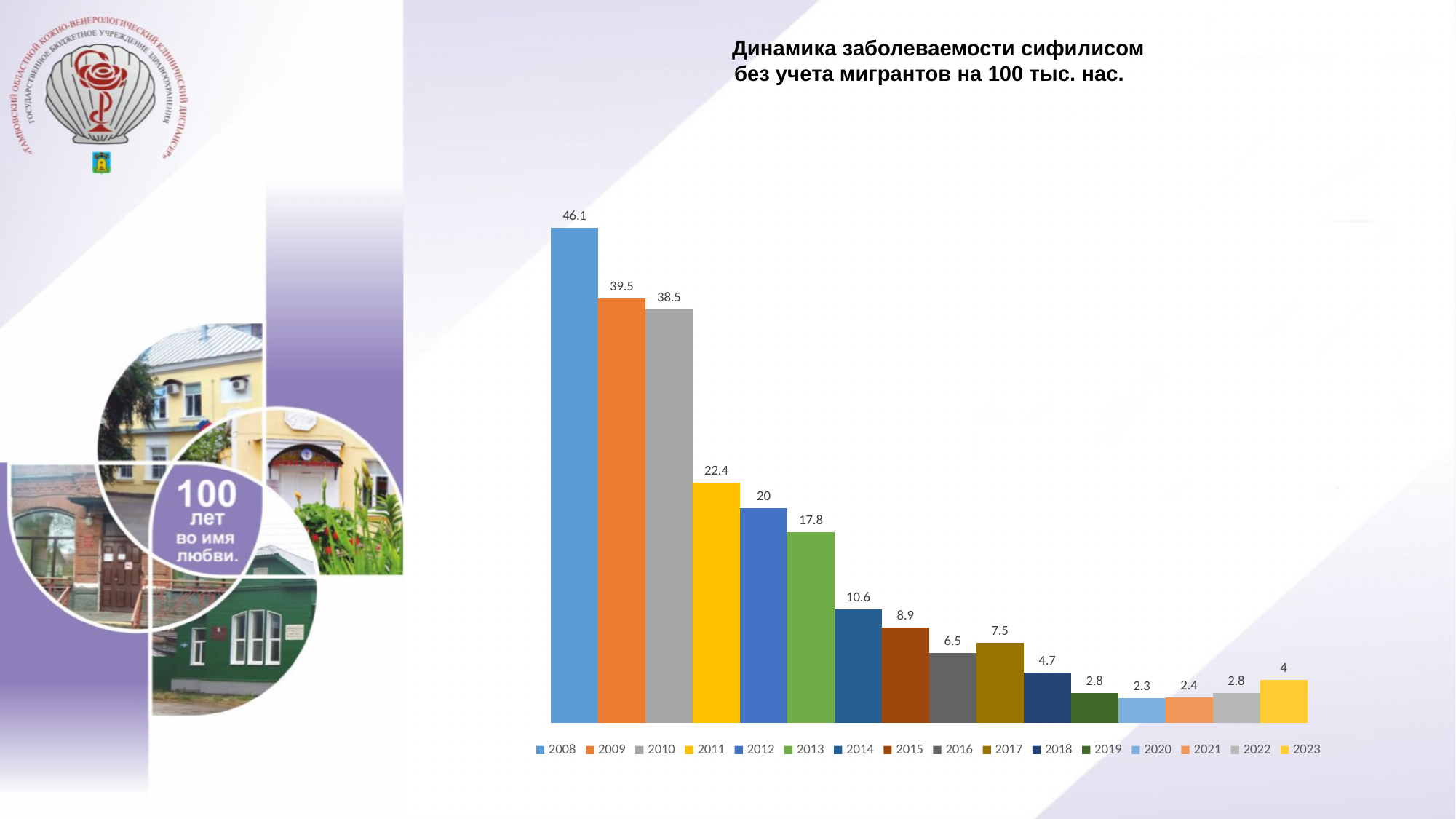
How many bars are plotted in the chart? 16 Do the values generally rise or fall from 2008 to 2020? fall How many entries does the legend list? 16 Which year has the highest value? 2008 What type of chart is shown on the slide? bar chart What is the value for 2023? 4 What is the difference between the values for 2008 and 2009? 6.6 What is the value for 2008? 46.1 What is the value for 2017? 7.5 Which is larger, the value for 2016 or the value for 2017? 2017 Which year has the lowest value? 2020 What is the value for 2013? 17.8